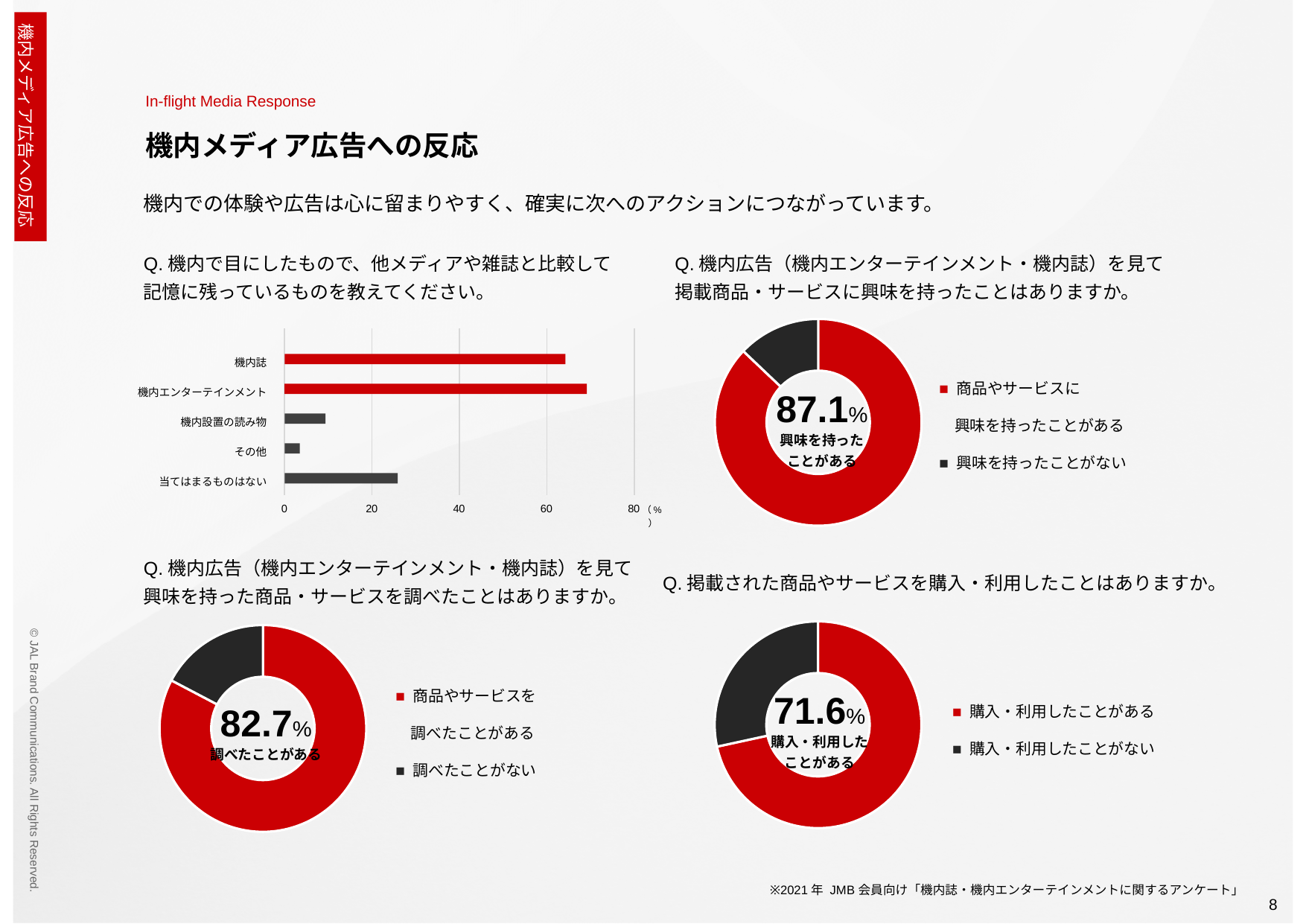
In the top-left bar chart, which category has the lowest value? その他 In the bottom-left donut chart, what share of respondents answered 商品やサービスを調べたことがある? 82.7% What kind of chart is the chart at the top left of the slide (under the question about what is remembered compared with other media)? bar chart In the top-left bar chart, is the value for 機内誌 greater or less than 60? greater How many categories does the top-left bar chart show? 5 In the bottom-right donut chart, what share of respondents answered 購入・利用したことがある? 71.6% In the top-right donut chart, what share of respondents answered 商品やサービスに興味を持ったことがある? 87.1% In the top-left bar chart, is the value for 当てはまるものはない greater or less than 40? less In the top-left bar chart, is the value for 機内設置の読み物 greater or less than 20? less How many entries does the legend of the bottom-right donut chart list? 2 In the top-left bar chart, which is larger: 当てはまるものはない or 機内設置の読み物? 当てはまるものはない In the top-left bar chart, which category has the highest value? 機内エンターテインメント